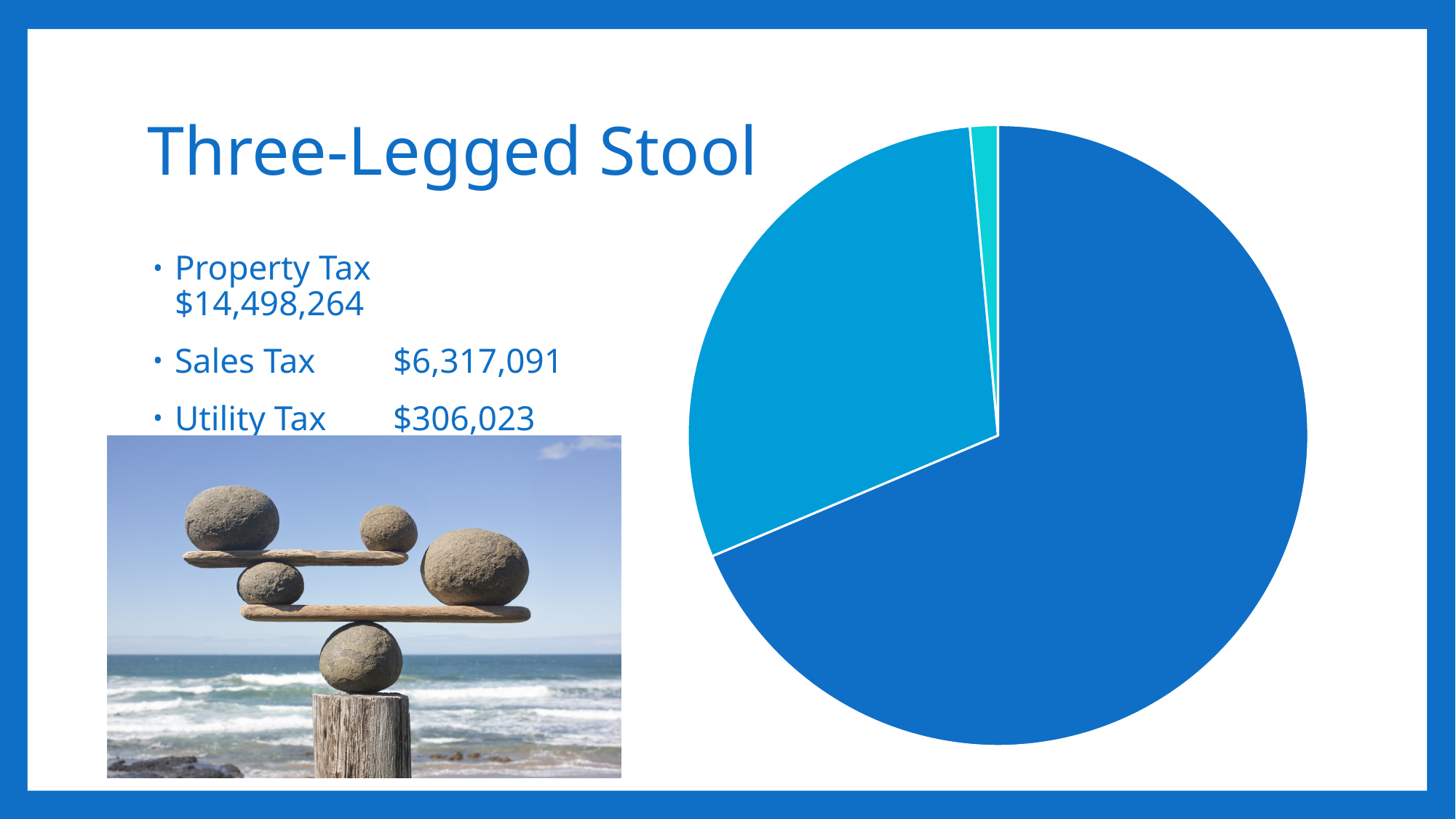
What is the value listed for Sales Tax? $6,317,091 What is the total of the three tax values shown in the pie chart? $21,121,378 What is the difference between Sales Tax and Utility Tax? $6,011,068 What kind of chart is shown on the slide? pie chart What is the difference between Property Tax and Sales Tax? $8,181,173 Which tax category has the smallest value and therefore the smallest slice of the pie? Utility Tax What is the title of the slide containing the pie chart? Three-Legged Stool Which is larger, Sales Tax or Utility Tax? Sales Tax What is the value listed for Utility Tax? $306,023 How many slices does the pie chart have? 3 What is the value listed for Property Tax? $14,498,264 Which tax category has the largest value and therefore the largest slice of the pie? Property Tax